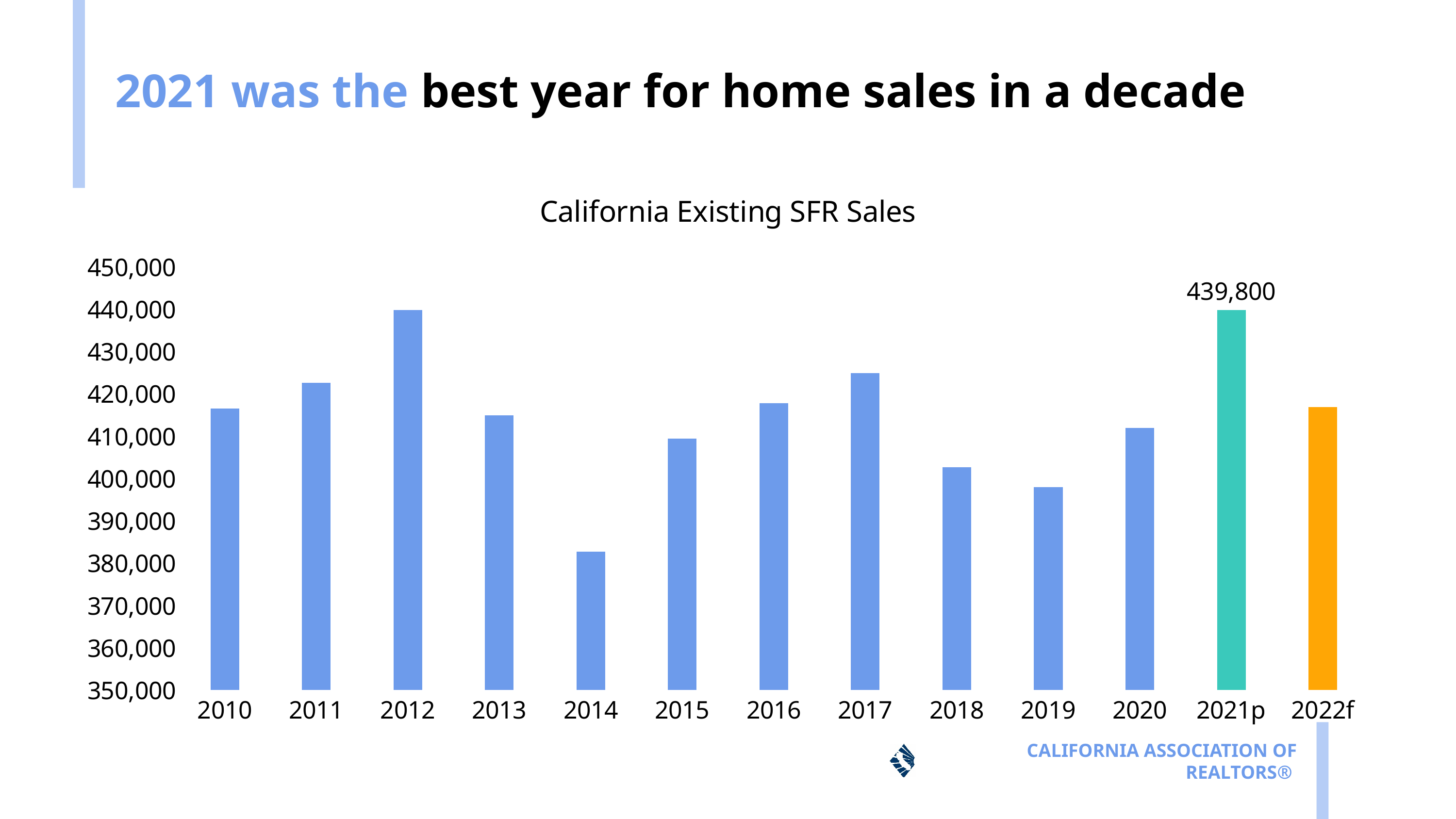
Which year has higher sales, 2014 or 2019? 2019 Is the value for 2022f greater or less than 410,000? greater Is the value for 2019 greater or less than 400,000? less What is the value shown for 2021p in the California Existing SFR Sales chart? 439,800 How many bars are plotted in the California Existing SFR Sales chart? 13 Which year has higher sales, 2016 or 2017? 2017 What type of chart is used to show California Existing SFR Sales? Bar chart Which year has higher sales, 2010 or 2011? 2011 What is the title of the chart on the slide? California Existing SFR Sales Is the value for 2014 greater or less than 390,000? less Which year has the lowest sales in the California Existing SFR Sales chart? 2014